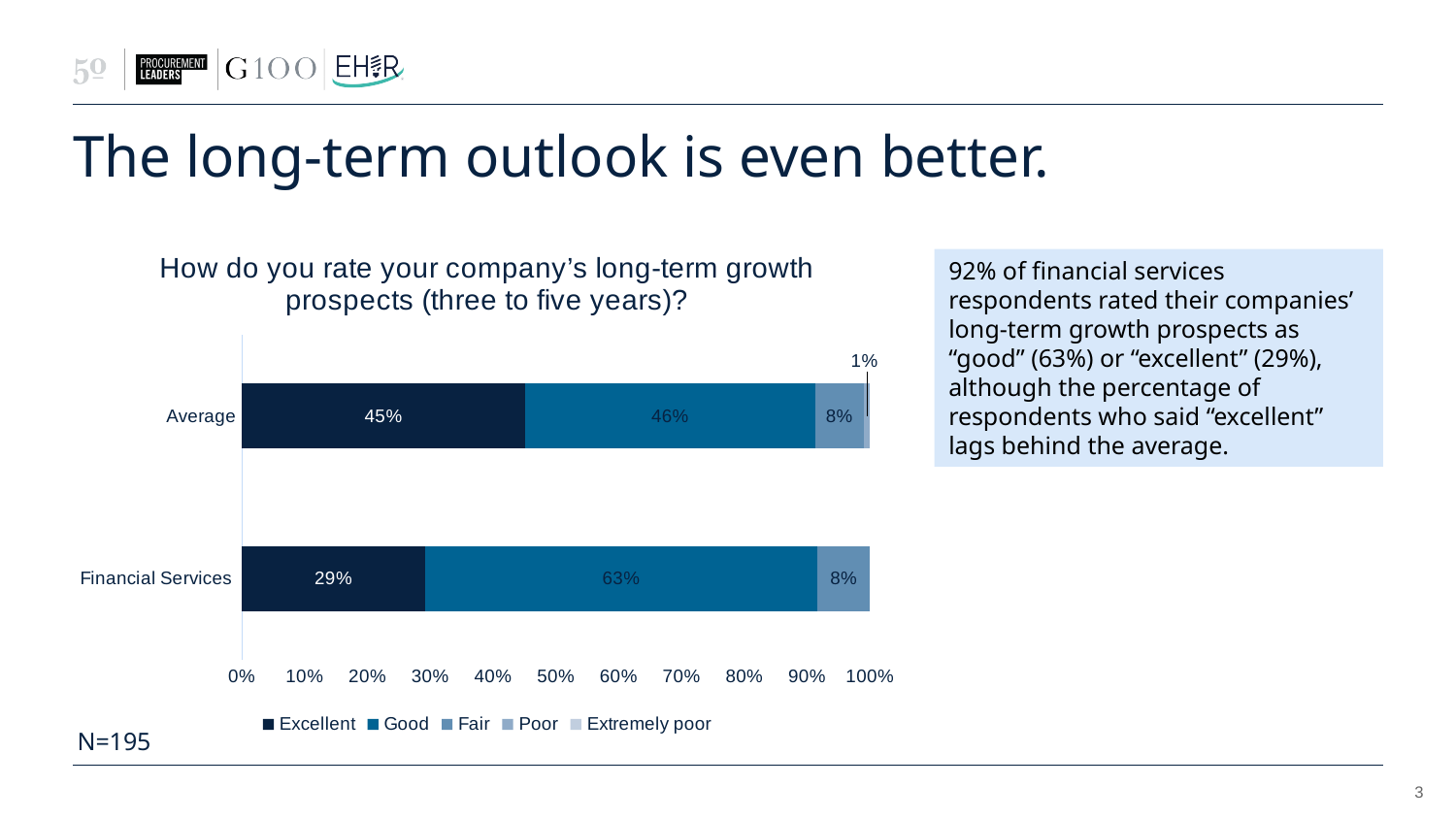
What is the sample size (N) stated on the slide? N=195 What type of chart is shown on the slide? Stacked bar chart What is the "Excellent" value for Financial Services? 29% What is the difference between the "Excellent" values for Average and Financial Services? 16% What is the "Good" value for the Average category? 46% Which category has the larger "Good" value, Average or Financial Services? Financial Services How many categories are shown on the chart? 2 How many series does the legend list? 5 Which category has the larger "Excellent" value, Average or Financial Services? Average What is the "Excellent" value for the Average category? 45% What percentage of Financial Services respondents rated their long-term growth prospects as "Good"? 63% What is the "Fair" value for Financial Services? 8%